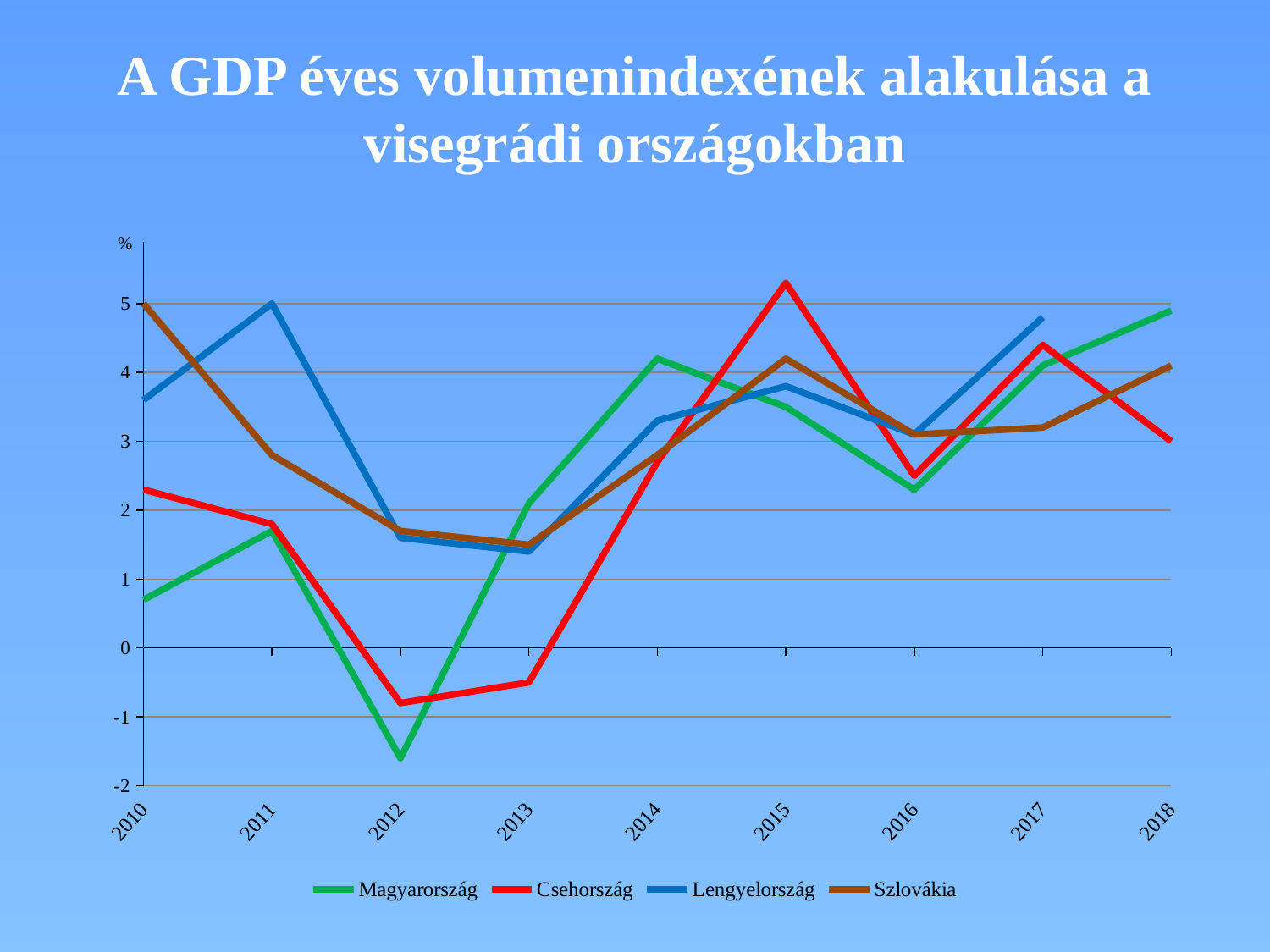
Which series is drawn in red in the legend? Csehország How many years are shown on the x axis? 9 Is the value for Csehország in 2015 greater or less than 5? greater What kind of chart is shown on the slide? line chart In which year does the Csehország line reach its highest value? 2015 In 2012, which is larger: the value for Magyarország or the value for Csehország? Csehország Does the Magyarország line rise or fall from 2016 to 2018? rise Is the value for Lengyelország in 2017 greater or less than 4? greater Is the value for Magyarország in 2012 greater or less than -1? less How many series does the legend list? 4 In which year does the Magyarország line reach its lowest value? 2012